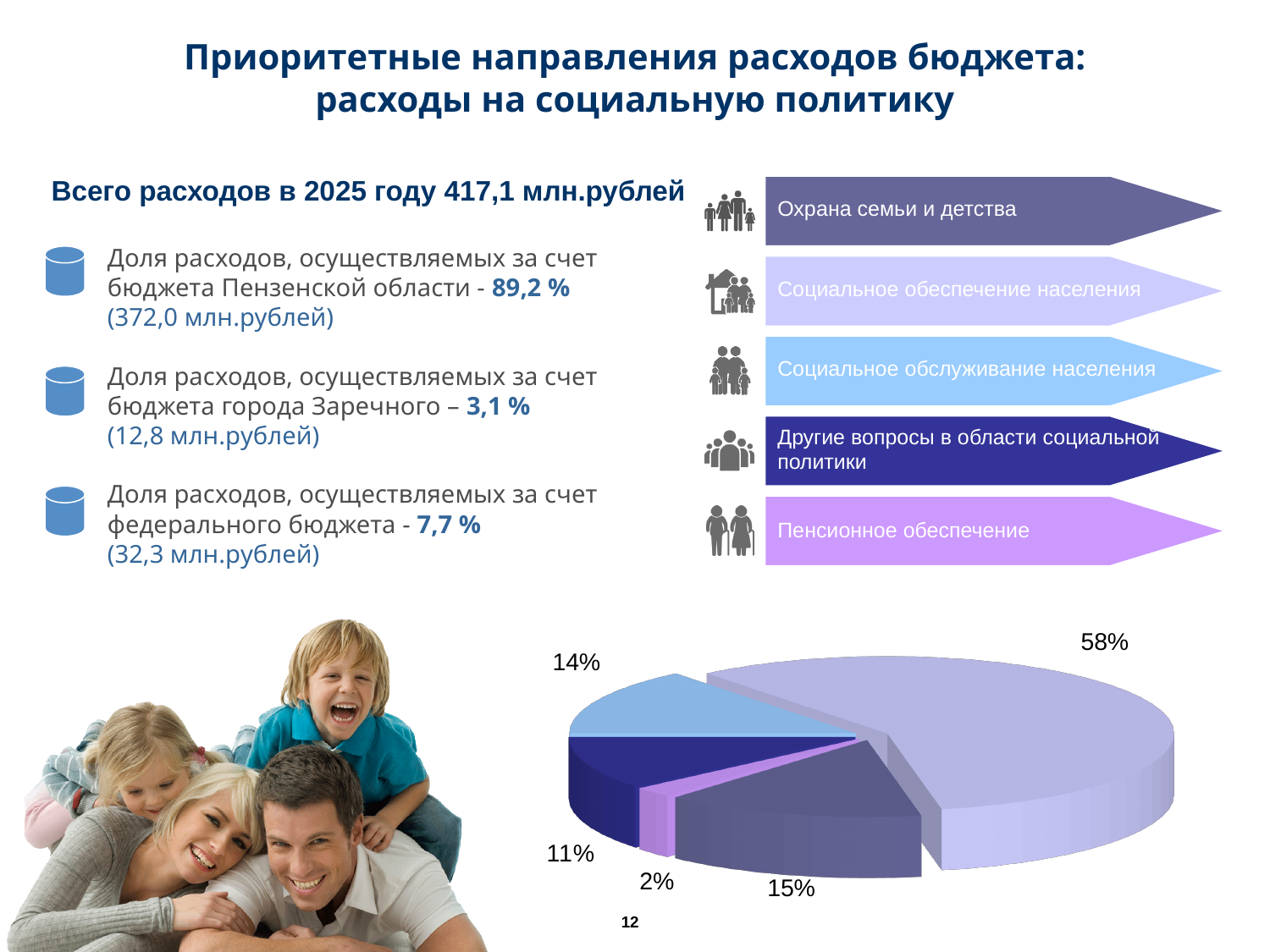
What kind of chart is shown on the slide? pie chart What is the largest share shown in the pie chart? 58% What share of the pie chart does the light lavender slice (Социальное обеспечение населения) represent? 58% What is the smallest share shown in the pie chart? 2% What share of the pie chart does the slice for Пенсионное обеспечение represent? 2% Which is larger: the slice for Социальное обслуживание населения or the slice for Другие вопросы в области социальной политики? Социальное обслуживание населения What share of the pie chart does the light blue slice (Социальное обслуживание населения) represent? 14% What is the difference between the largest slice (58%) and the slice for Охрана семьи и детства (15%)? 43% Which category in the legend is shown in light blue? Социальное обслуживание населения How many slices does the pie chart have? 5